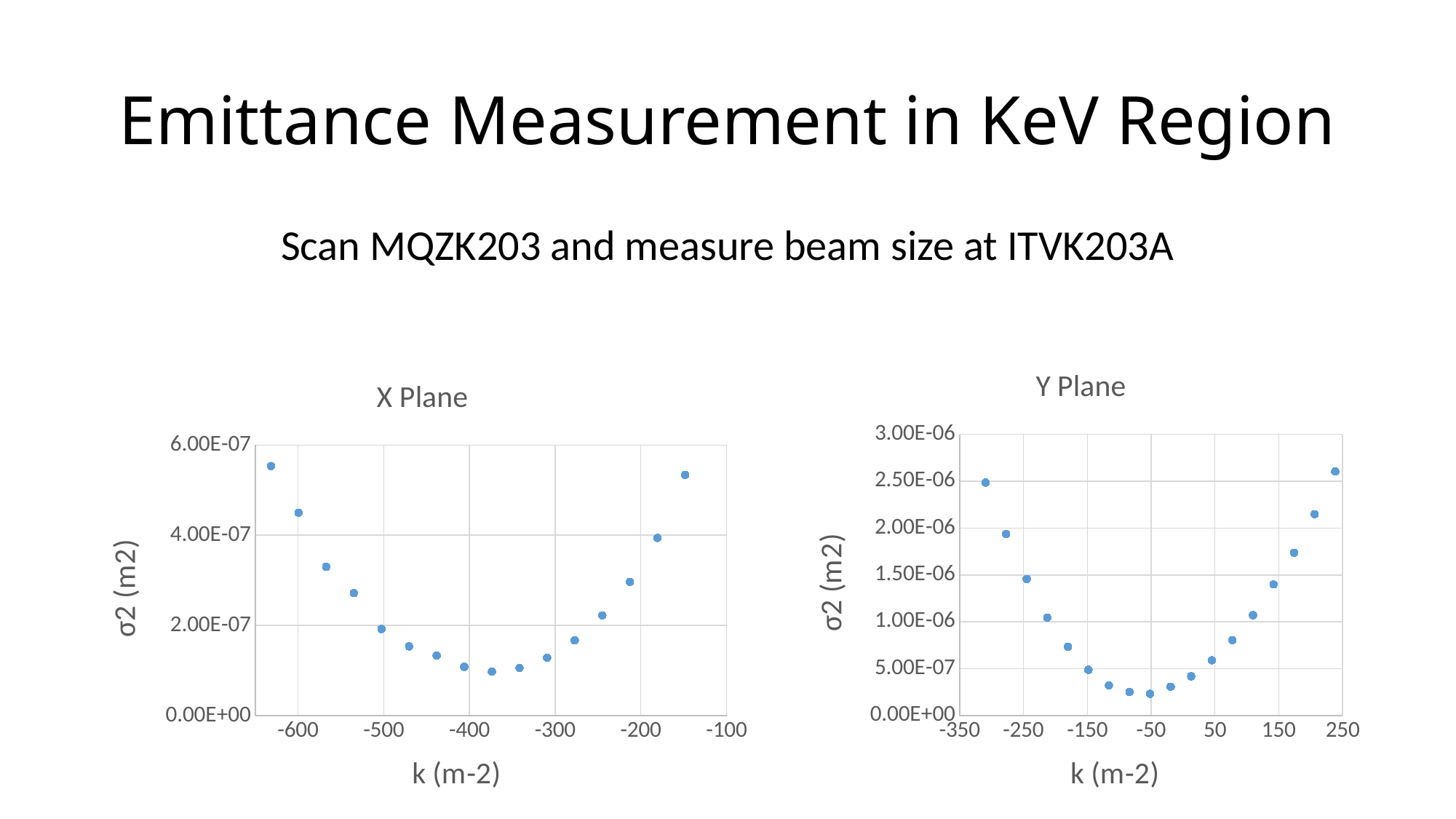
In the X Plane chart, is the lowest point (around k = -375) greater or less than 2.00E-07? less In the Y Plane chart, is the lowest point (around k = -50) greater or less than 5.00E-07? less What is the highest y-axis tick label on the Y Plane chart? 3.00E-06 What kind of chart is the X Plane chart? scatter chart In the X Plane chart, is the value at k = -600 greater or less than the value at k = -500? greater What kind of chart is the Y Plane chart? scatter chart In the Y Plane chart, is the value at the rightmost point (around k = 240) greater or less than 2.00E-06? greater In the Y Plane chart, how do the values change as k increases from -350 to 250? they fall to a minimum near -50 and then rise In the X Plane chart, how do the values change as k increases from -630 to -100? they fall to a minimum near -375 and then rise What is the x-axis title of the X Plane chart? k (m-2) In the Y Plane chart, is the value at k = -310 greater or less than the value at k = 50? greater